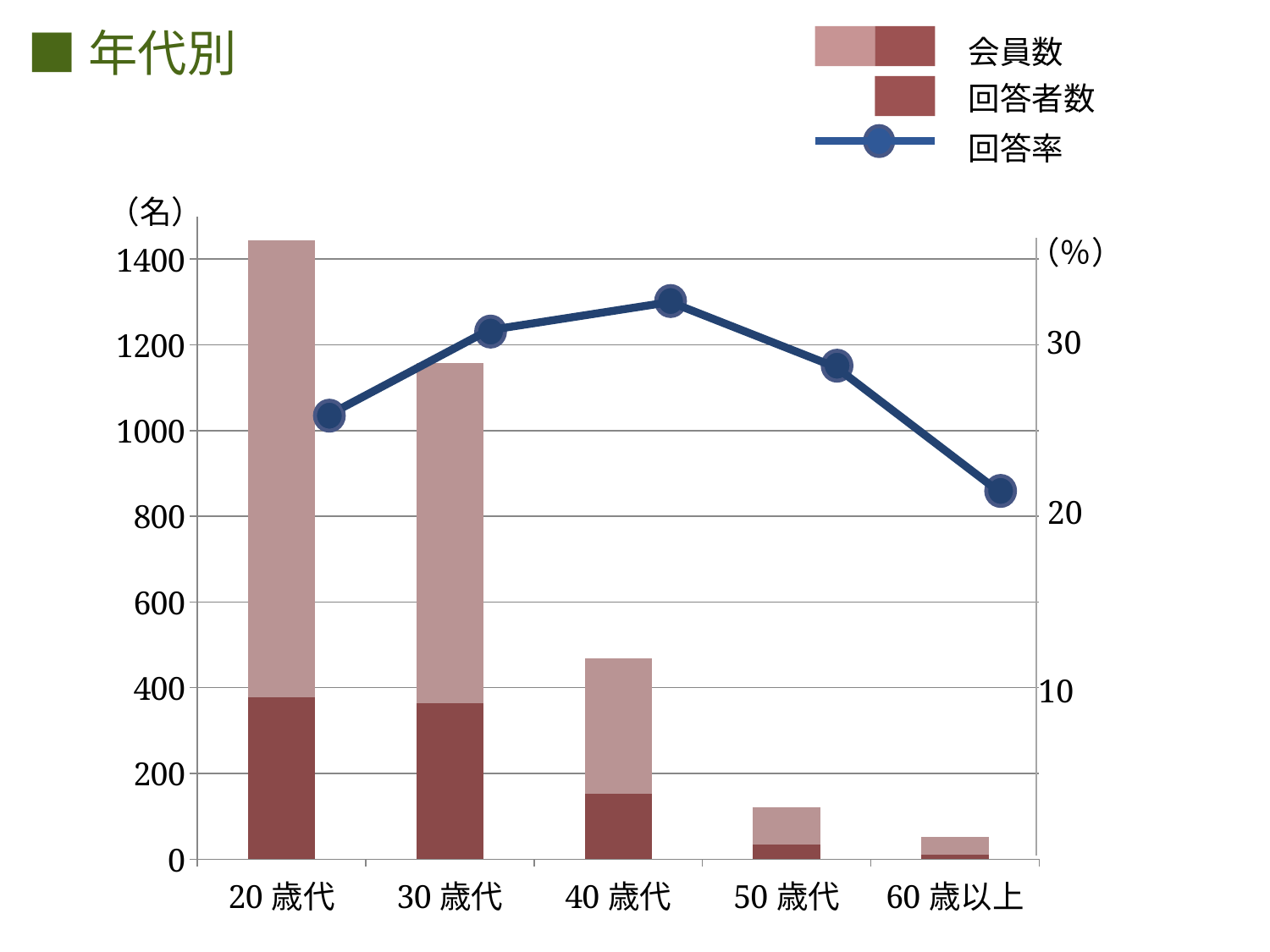
Does the 回答率 line rise or fall from 40 歳代 to 60 歳以上? fall Is the 会員数 value for 40 歳代 greater or less than 400? greater How many series does the legend list? 3 Which age category has the lowest 会員数? 60 歳以上 How many age categories are shown on the x axis? 5 Which age category has the highest 回答率? 40 歳代 What kind of chart is shown on the slide? A combination bar and line chart Which has the larger 会員数, 30 歳代 or 40 歳代? 30 歳代 Is the 会員数 value for 20 歳代 greater or less than 1200? greater Which age category has the highest 会員数? 20 歳代 Which age category has the lowest 回答率? 60 歳以上 Is the 回答率 value for 20 歳代 greater or less than 30? less